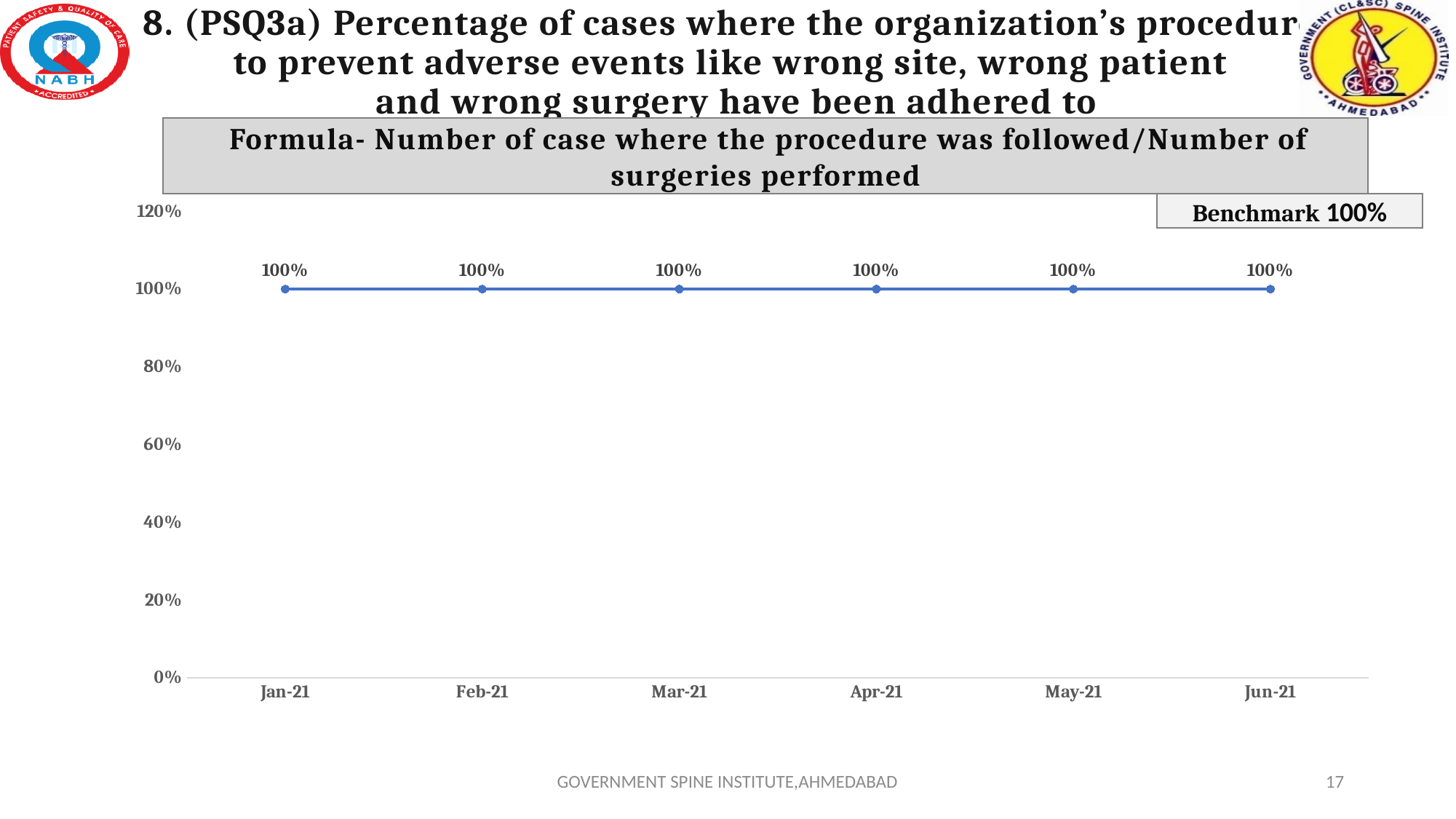
What is the value for Jan-21? 100% How many months are plotted on the x axis? 6 What is the highest value shown on the y axis? 120% What is the value for Jun-21? 100% What is the difference between the values for Mar-21 and May-21? 0% Is the value for Feb-21 greater or less than 80%? greater What benchmark value is shown on the slide? 100% What is the value for Apr-21? 100% What kind of chart is shown on the slide? line chart Do the values rise, fall, or stay flat from Jan-21 to Jun-21? stay flat